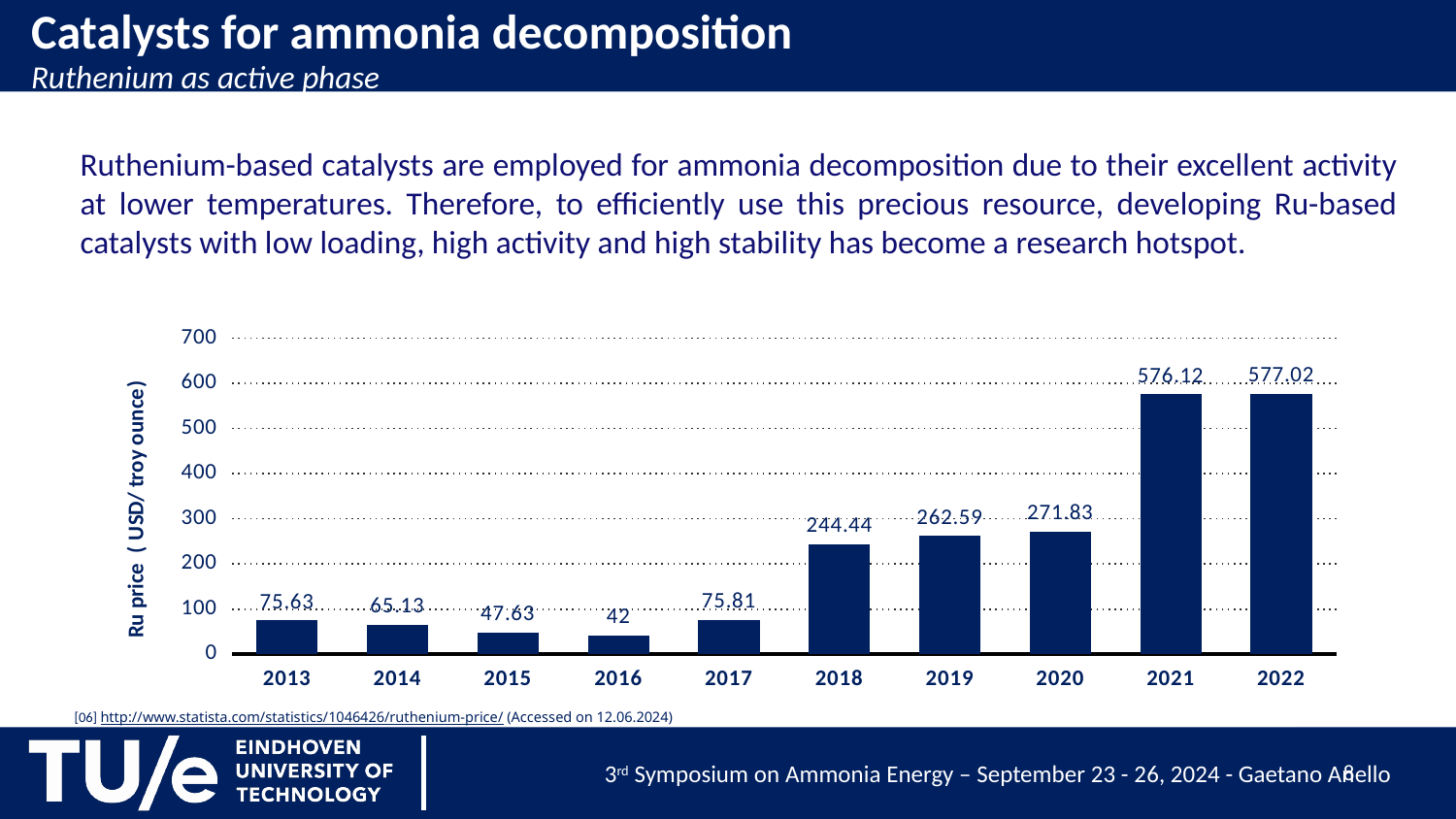
Which year has the highest Ru price in the chart? 2022 What is the Ru price shown for 2016? 42 Which year has the lowest Ru price in the chart? 2016 What is the difference between the Ru price in 2018 and in 2017? 168.63 What kind of chart is used to show the Ru price? bar chart Is the Ru price for 2019 greater or less than 200? greater What is the Ru price shown for 2018? 244.44 What is the difference between the Ru price in 2021 and in 2020? 304.29 Which year has a higher Ru price, 2014 or 2019? 2019 What is the Ru price shown for 2020? 271.83 How many years are shown on the x axis of the chart? 10 Does the Ru price rise or fall from 2013 to 2016? fall